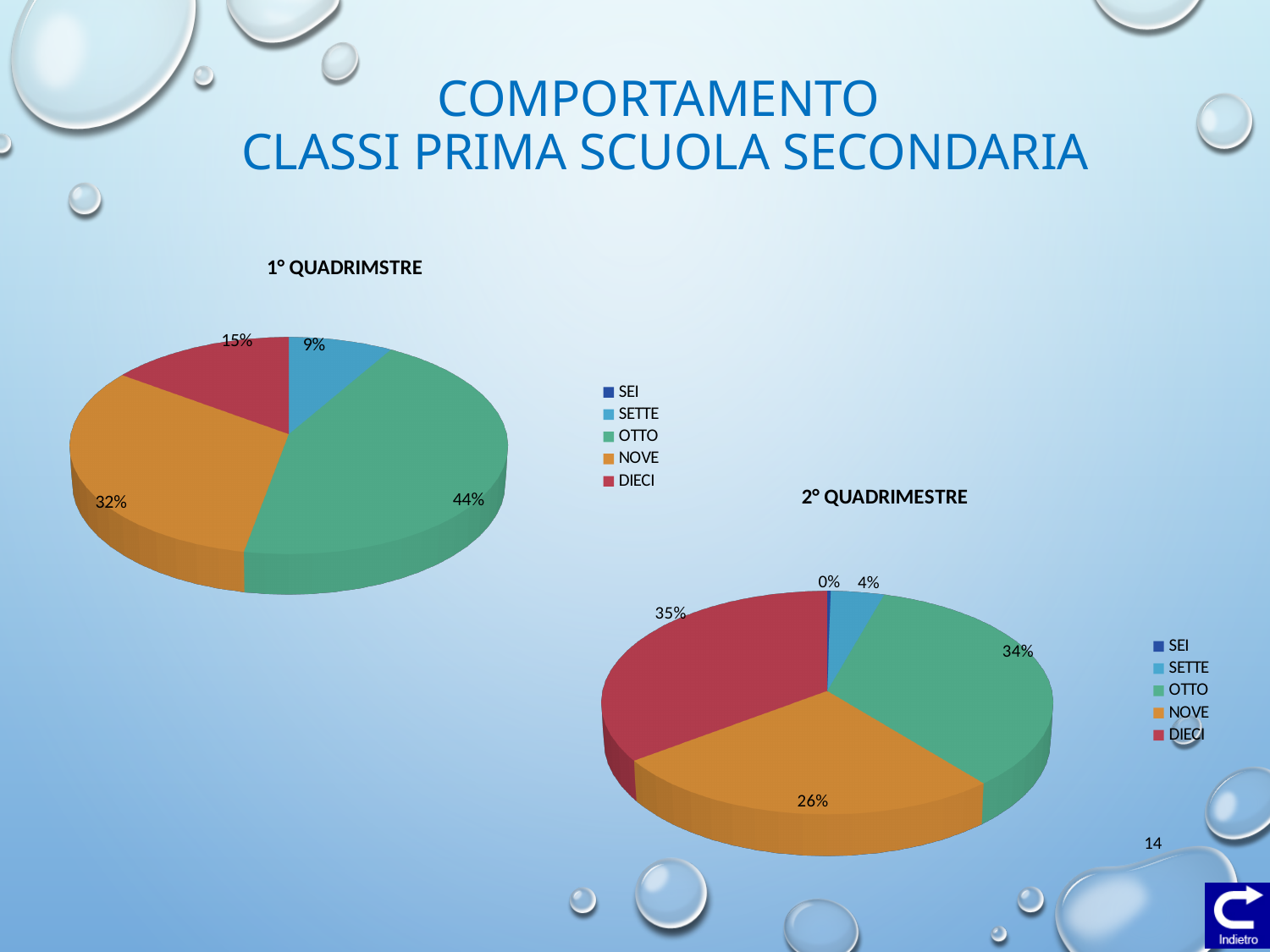
What type of chart is the "1° QUADRIMSTRE" chart? pie chart In the "2° QUADRIMESTRE" chart, what share does SEI have? 0% In the "2° QUADRIMESTRE" chart, which is larger, the share of OTTO or the share of NOVE? OTTO In the "2° QUADRIMESTRE" chart, what is the difference between the shares of DIECI and NOVE? 9% In the "1° QUADRIMSTRE" chart, which category has the largest share? OTTO In the "2° QUADRIMESTRE" chart, what share does SETTE have? 4% How many entries does the legend of the "2° QUADRIMESTRE" chart list? 5 In the "1° QUADRIMSTRE" chart, what share does DIECI have? 15% In the "1° QUADRIMSTRE" chart, what share does OTTO have? 44% In the "2° QUADRIMESTRE" chart, what share does DIECI have? 35% In the "1° QUADRIMSTRE" chart, what share does NOVE have? 32% In the "1° QUADRIMSTRE" chart, what is the difference between the shares of OTTO and NOVE? 12%